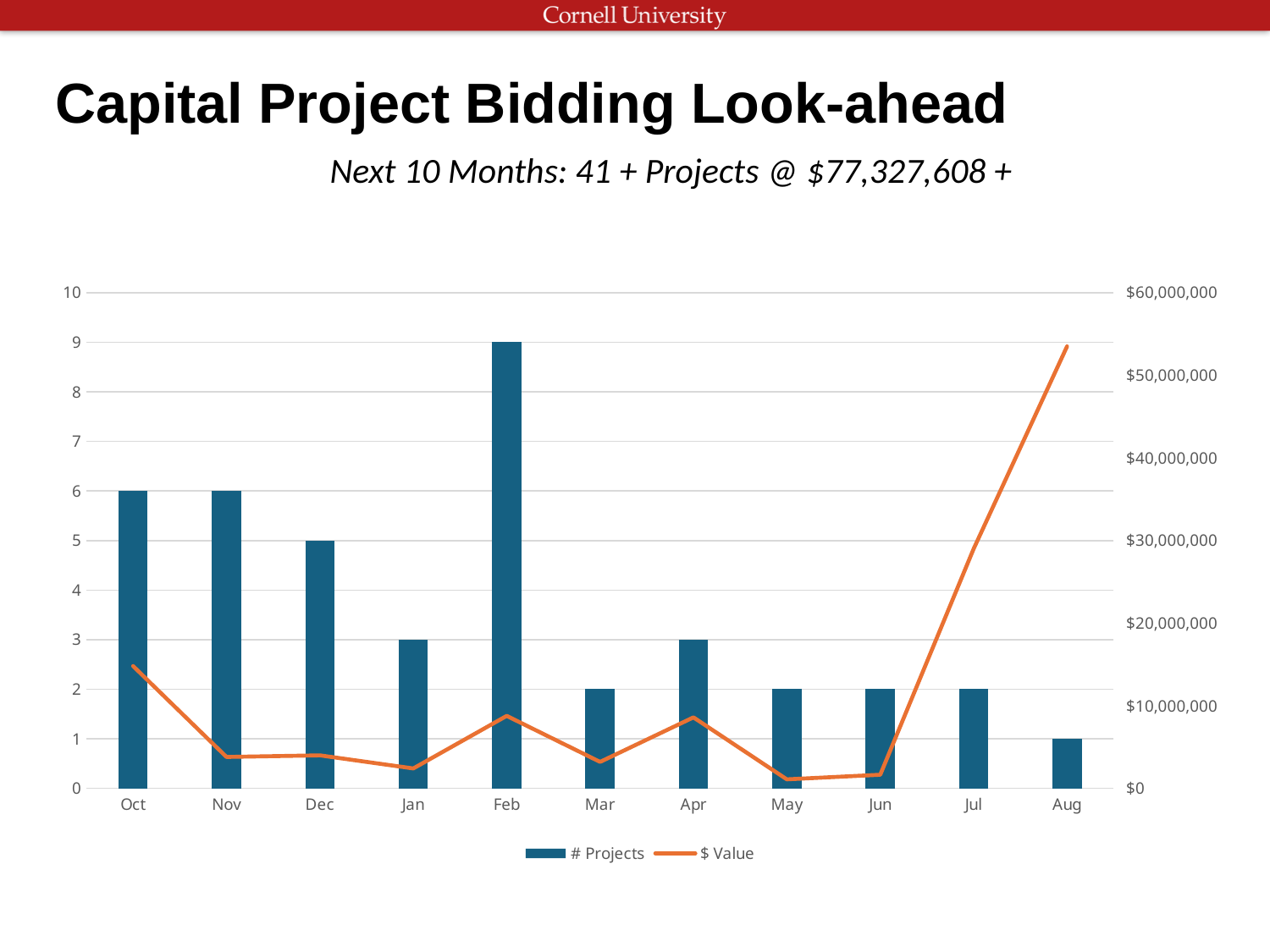
Which month has the lowest number of projects? Aug How many projects are shown for Dec? 5 How many series does the legend list? 2 What kind of chart is shown on the slide? Combination bar and line chart Which month has the highest number of projects? Feb Is the $ Value for Nov greater or less than $10,000,000? less Is the $ Value for Aug greater or less than $50,000,000? greater How many projects are shown for Feb? 9 How many projects are shown for Aug? 1 How many months are shown on the x axis? 11 What is the difference in the number of projects between Feb and Jan? 6 Which month has more projects, Oct or Apr? Oct